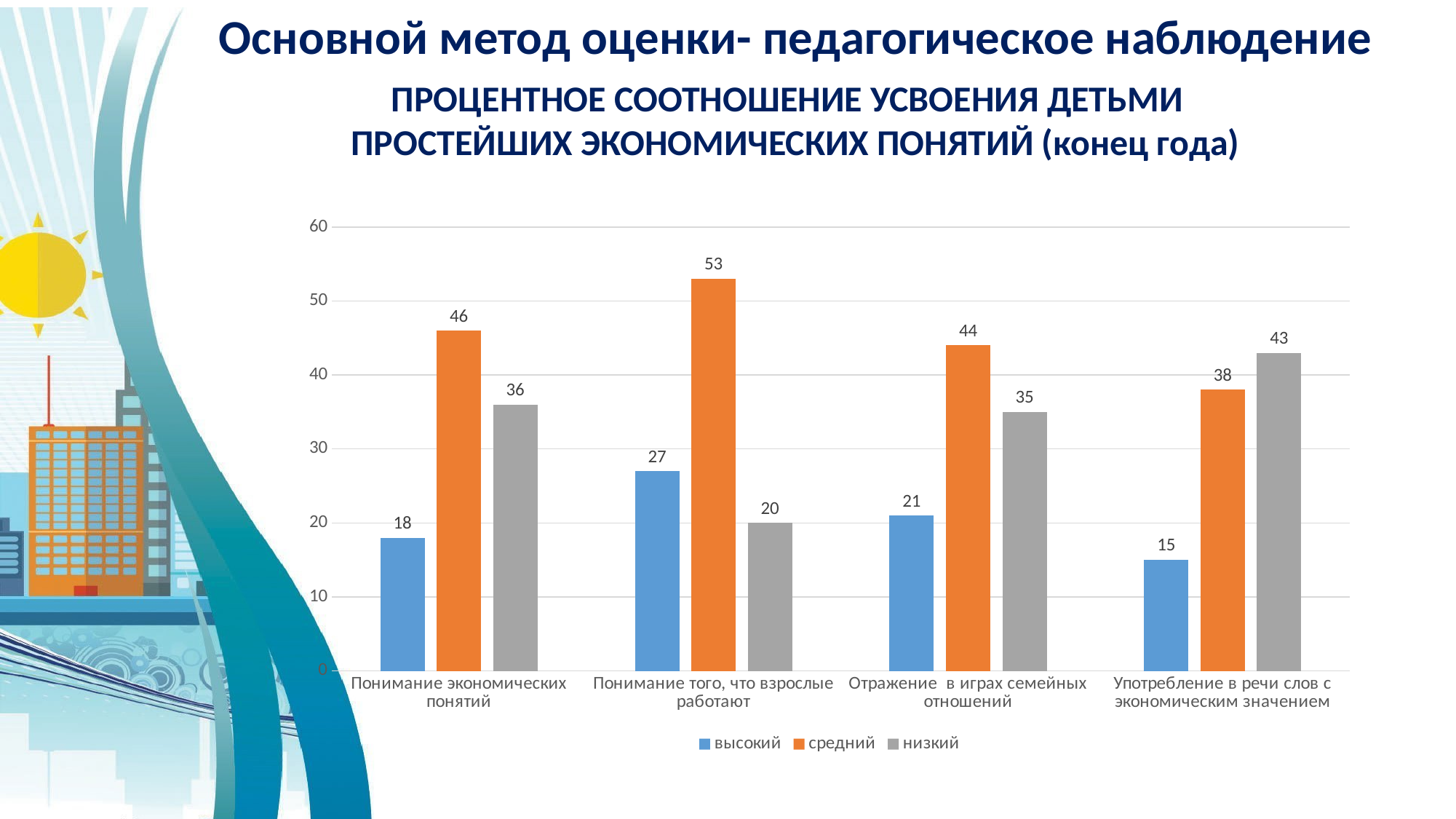
Is the value for "низкий" in "Понимание того, что взрослые работают" greater or less than 30? less In the category "Употребление в речи слов с экономическим значением", which is larger: "средний" or "низкий"? низкий What is the value for "средний" in the category "Понимание того, что взрослые работают"? 53 What is the value for "высокий" in the category "Отражение в играх семейных отношений"? 21 What kind of chart is shown on the slide? bar chart What is the value for "низкий" in the category "Употребление в речи слов с экономическим значением"? 43 What is the difference between the "средний" and "высокий" values in the category "Понимание экономических понятий"? 28 Which category has the highest value for the "средний" series? Понимание того, что взрослые работают What colour are the bars for the "средний" series? orange Which category has the lowest value for the "высокий" series? Употребление в речи слов с экономическим значением How many series does the legend list? 3 How many categories are shown on the x axis? 4